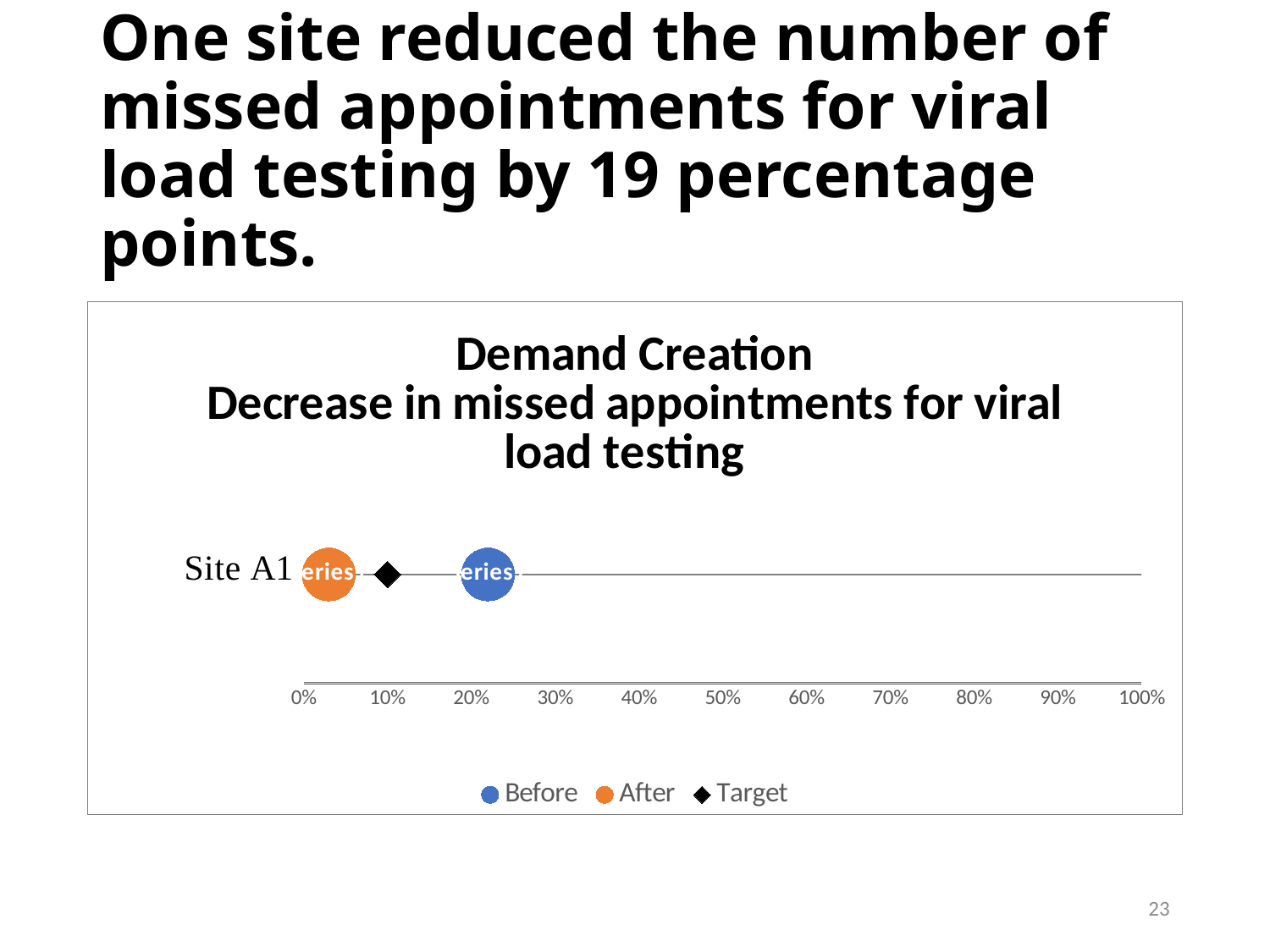
Is the Target value for Site A1 greater or less than the Before value? less For Site A1, is the Before value or the After value larger? Before What is the name of the site shown on the chart? Site A1 Which series has the highest value for Site A1? Before Is the Target value for Site A1 greater or less than 50%? less Which series has the lowest value for Site A1? After Is the After value for Site A1 greater or less than 10%? less Which series are listed in the chart legend? Before, After, Target How many series does the chart legend list? 3 What kind of chart is shown on the slide? Scatter (dot) chart How many sites are plotted on the chart? 1 Is the Before value for Site A1 greater or less than 10%? greater